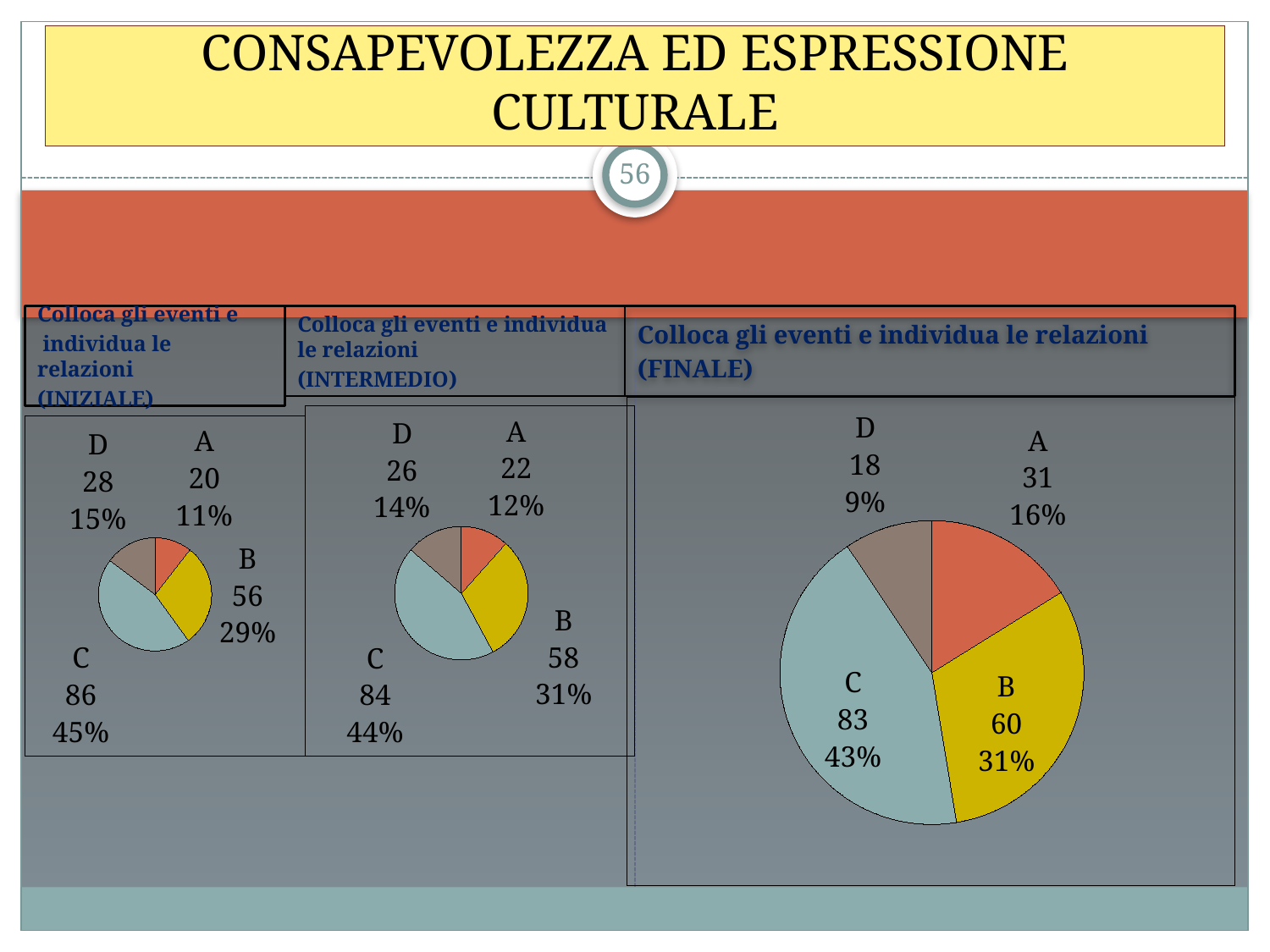
In the FINALE pie chart, what percentage share does category C have? 43% In the INIZIALE pie chart, what percentage share does category B have? 29% In the INIZIALE pie chart, what is the value for category C? 86 In the FINALE pie chart, what is the value for category A? 31 In the INIZIALE pie chart, which category has the smallest value? A In the FINALE pie chart, which is larger, the value for B or the value for D? B How many categories does the INTERMEDIO pie chart show? 4 In the INTERMEDIO pie chart, what is the difference between the values for C and B? 26 What kind of chart is used in the FINALE panel? Pie chart In the INTERMEDIO pie chart, what is the value for category D? 26 What is the difference between the value for A in the FINALE chart and the value for A in the INIZIALE chart? 11 In the FINALE pie chart, which category has the largest value? C